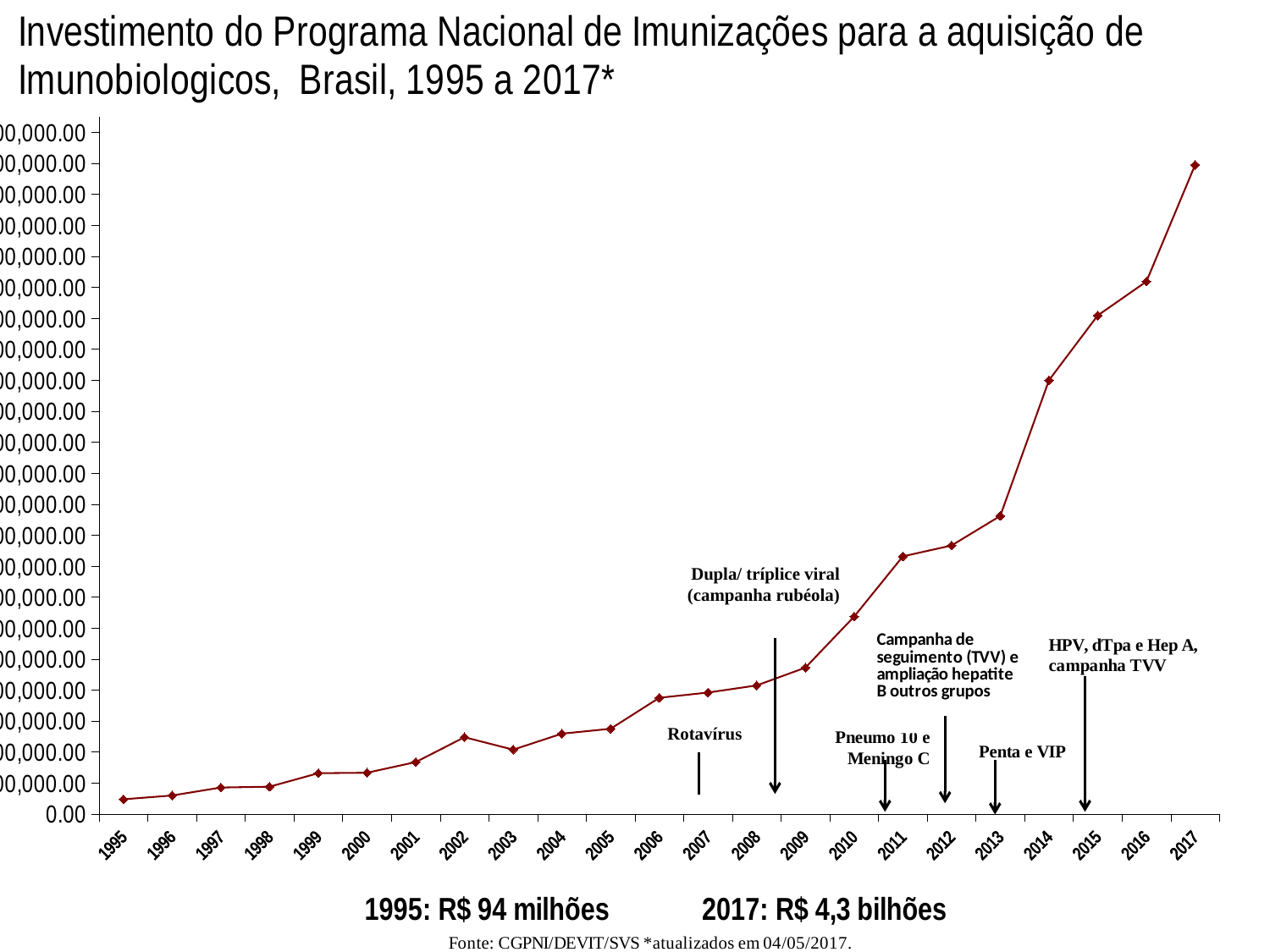
Which year has the larger investment value, 2011 or 2013? 2013 How many years (data points) are plotted on the chart? 23 Which vaccine introduction is annotated at the year 2007 on the chart? Rotavírus Which annotation is placed at the year 2013 on the chart? Penta e VIP Which year has the lowest investment value on the chart? 1995 Which year has the larger investment value, 2014 or 2016? 2016 Do the investment values generally rise or fall from 1995 to 2017? Rise What kind of chart is shown on the slide? Line chart Which year has the highest investment value on the chart? 2017 According to the text on the slide, what was the investment in 2017? R$ 4,3 bilhões According to the text on the slide, what was the investment in 1995? R$ 94 milhões Which year has the larger investment value, 2002 or 2003? 2002